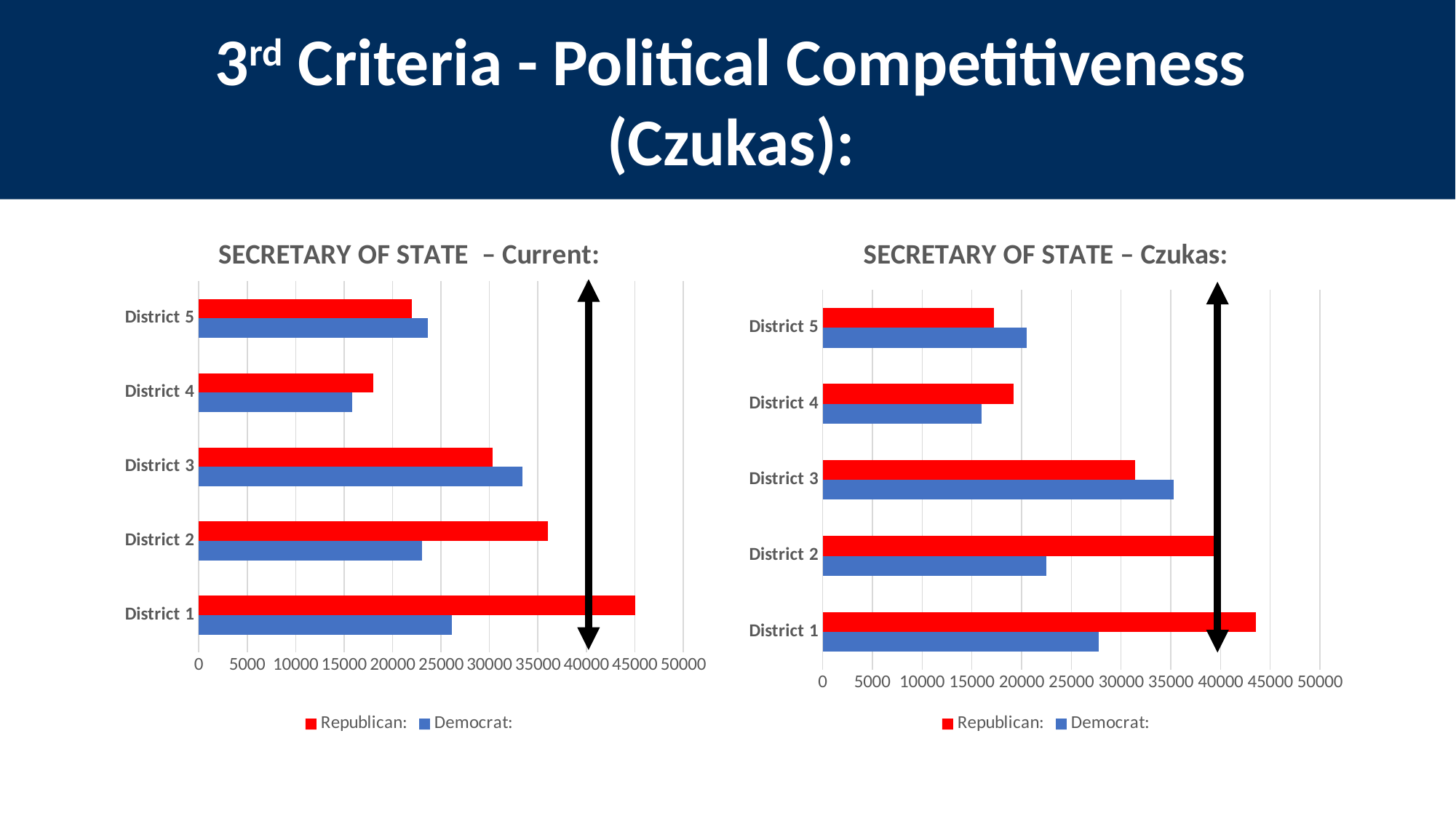
In the "SECRETARY OF STATE – Czukas:" chart, is the Republican value for District 2 greater or less than 35000? greater In the "SECRETARY OF STATE – Current:" chart, which is larger for District 2, the Republican or the Democrat value? Republican What kind of chart is the "SECRETARY OF STATE – Current:" chart? Bar chart In the "SECRETARY OF STATE – Current:" chart, which district has the lowest Democrat value? District 4 In the "SECRETARY OF STATE – Current:" chart, is the Republican value for District 1 greater or less than 40000? greater In the "SECRETARY OF STATE – Czukas:" chart, which is larger for District 3, the Republican or the Democrat value? Democrat In the "SECRETARY OF STATE – Czukas:" chart, is the Democrat value for District 4 greater or less than 20000? less How many series does the legend of the "SECRETARY OF STATE – Czukas:" chart list? 2 In the "SECRETARY OF STATE – Czukas:" chart, which district has the highest Democrat value? District 3 In the "SECRETARY OF STATE – Current:" chart, which district has the highest Republican value? District 1 In the "SECRETARY OF STATE – Czukas:" chart, what colour represents the Democrat series? Blue How many districts are shown on the "SECRETARY OF STATE – Current:" chart? 5